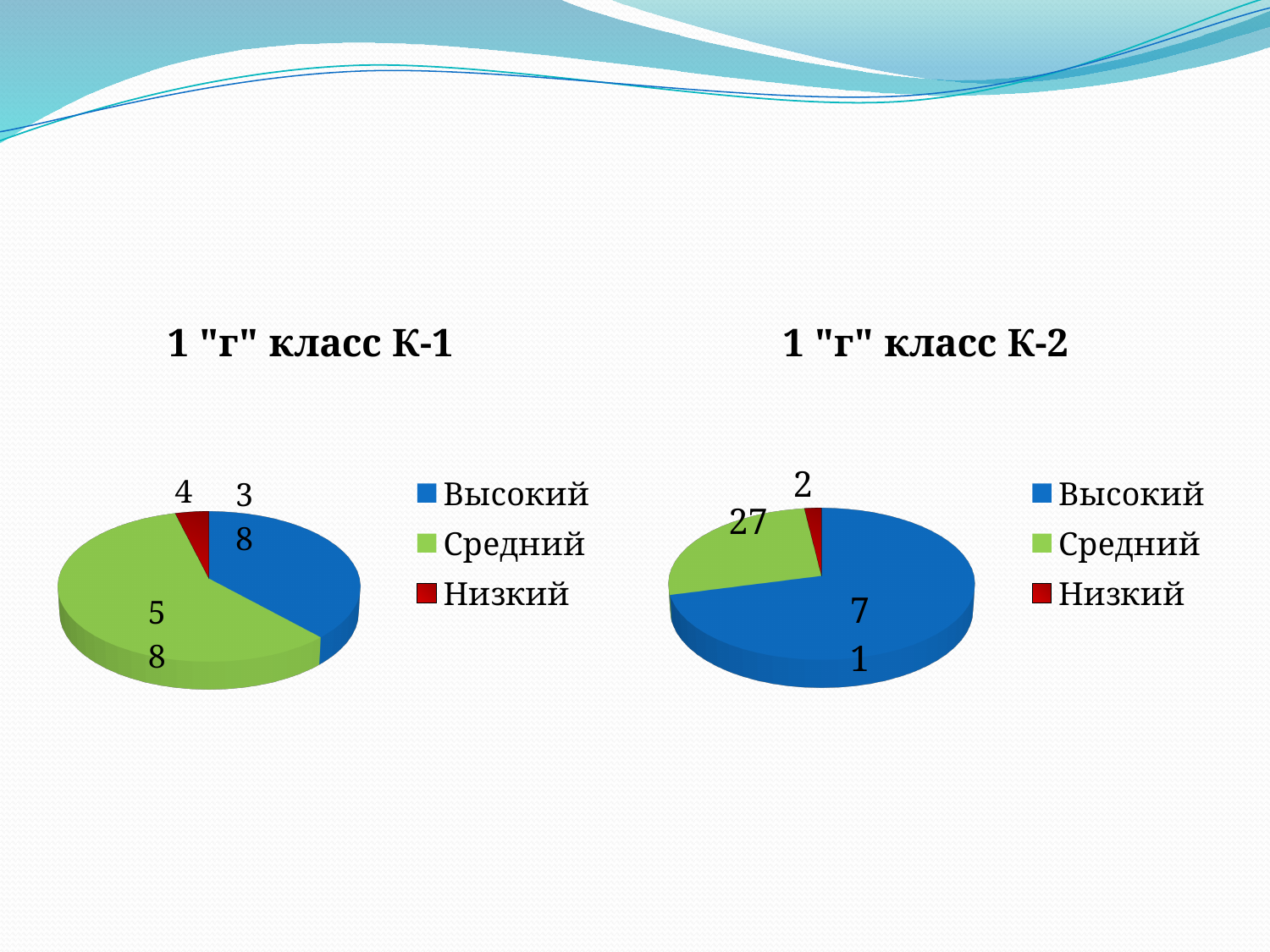
How many categories does the legend of the chart titled 1 "г" класс К-2 list? 3 In the chart titled 1 "г" класс К-1, what is the value for Высокий? 38 In the chart titled 1 "г" класс К-1, which category has the smallest slice? Низкий In the chart titled 1 "г" класс К-1, what is the value for Средний? 58 What kind of chart is the chart titled 1 "г" класс К-1? Pie chart In the chart titled 1 "г" класс К-1, which category has the largest slice? Средний In the chart titled 1 "г" класс К-2, what is the value for Высокий? 71 In the chart titled 1 "г" класс К-1, which is larger, Высокий or Средний? Средний In the chart titled 1 "г" класс К-2, which category has the largest slice? Высокий In the chart titled 1 "г" класс К-2, what is the difference between the values for Высокий and Средний? 44 In the chart titled 1 "г" класс К-2, what is the value for Средний? 27 In the chart titled 1 "г" класс К-1, what is the value for Низкий? 4